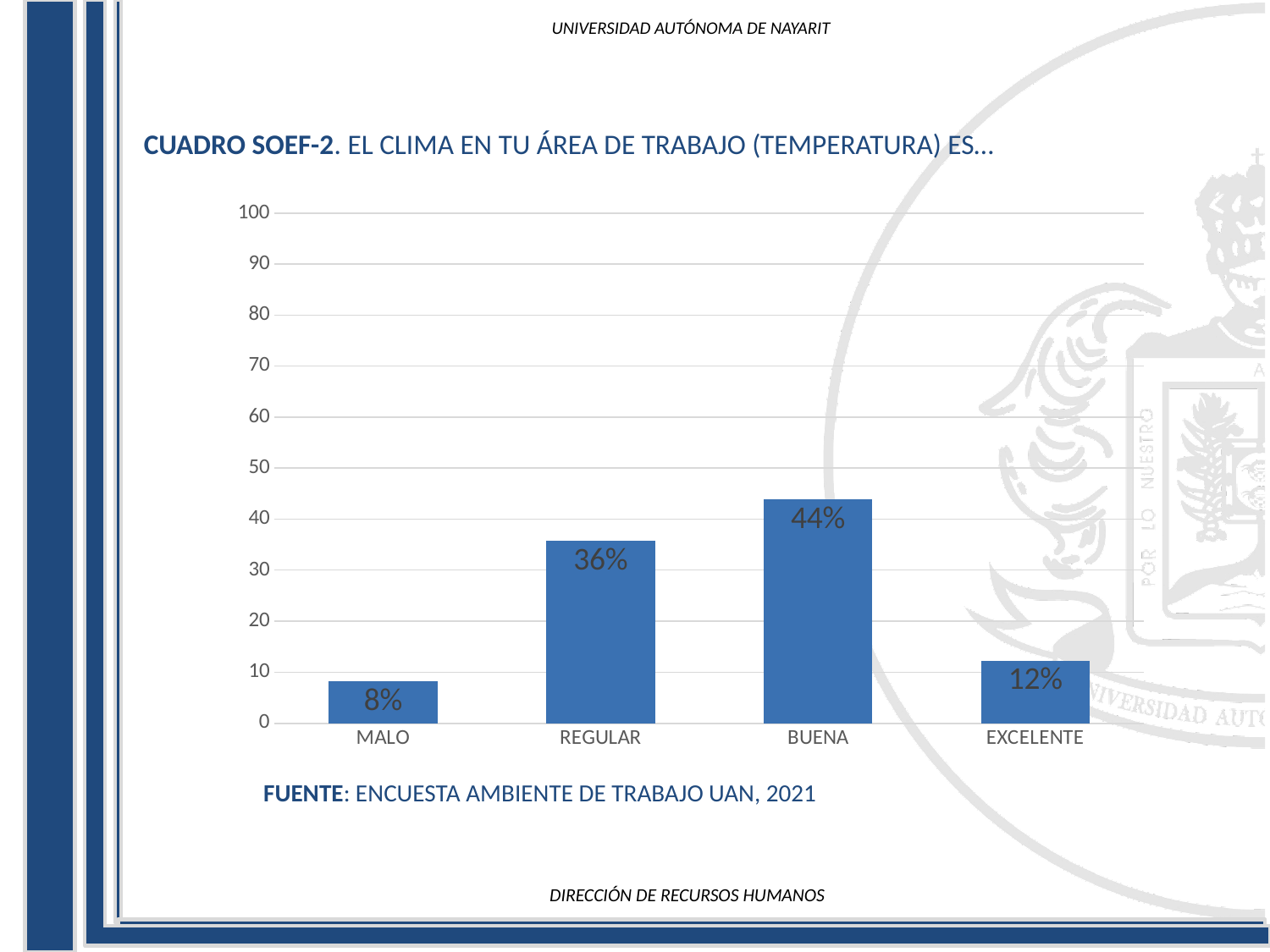
What is the value for EXCELENTE? 12% What is the difference between the values for BUENA and REGULAR? 8% How many categories are shown on the x axis? 4 What kind of chart is shown on the slide? bar chart Which is larger, the value for REGULAR or the value for EXCELENTE? REGULAR Which category has the highest value? BUENA What is the difference between the values for EXCELENTE and MALO? 4% Which category has the lowest value? MALO Is the value for REGULAR greater or less than 30? greater What is the source cited below the chart? ENCUESTA AMBIENTE DE TRABAJO UAN, 2021 What is the value for BUENA? 44% What is the value for MALO? 8%